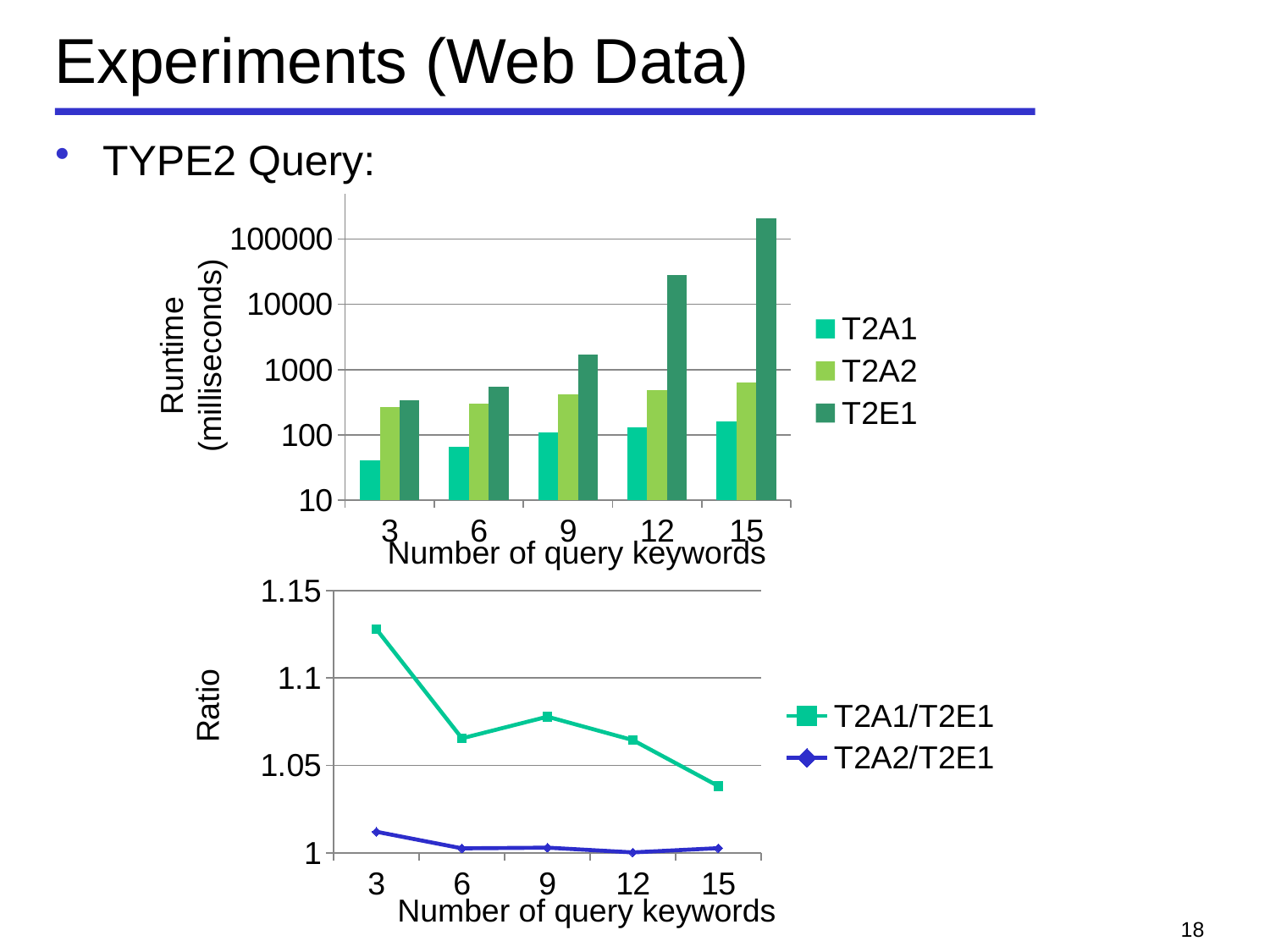
In the bottom Ratio chart, how many categories are shown on the x axis? 5 In the top Runtime chart, which series has the shortest bar at 3 query keywords? T2A1 In the top Runtime chart, is the T2E1 value at 15 query keywords greater or less than 100000? greater In the bottom Ratio chart, which series has the higher value at 9 query keywords, T2A1/T2E1 or T2A2/T2E1? T2A1/T2E1 In the bottom Ratio chart, does the T2A1/T2E1 series generally rise or fall as the number of query keywords increases? fall In the top Runtime chart, is the T2E1 value at 12 query keywords greater or less than 10000? greater In the top Runtime chart, which series has the tallest bar at 15 query keywords? T2E1 In the top Runtime chart, is the T2A1 value at 3 query keywords greater or less than 100? less What kind of chart is the bottom chart on the slide (Ratio vs. number of query keywords)? line chart In the top Runtime chart, how many series does the legend list? 3 What kind of chart is the top chart on the slide (Runtime vs. number of query keywords)? bar chart